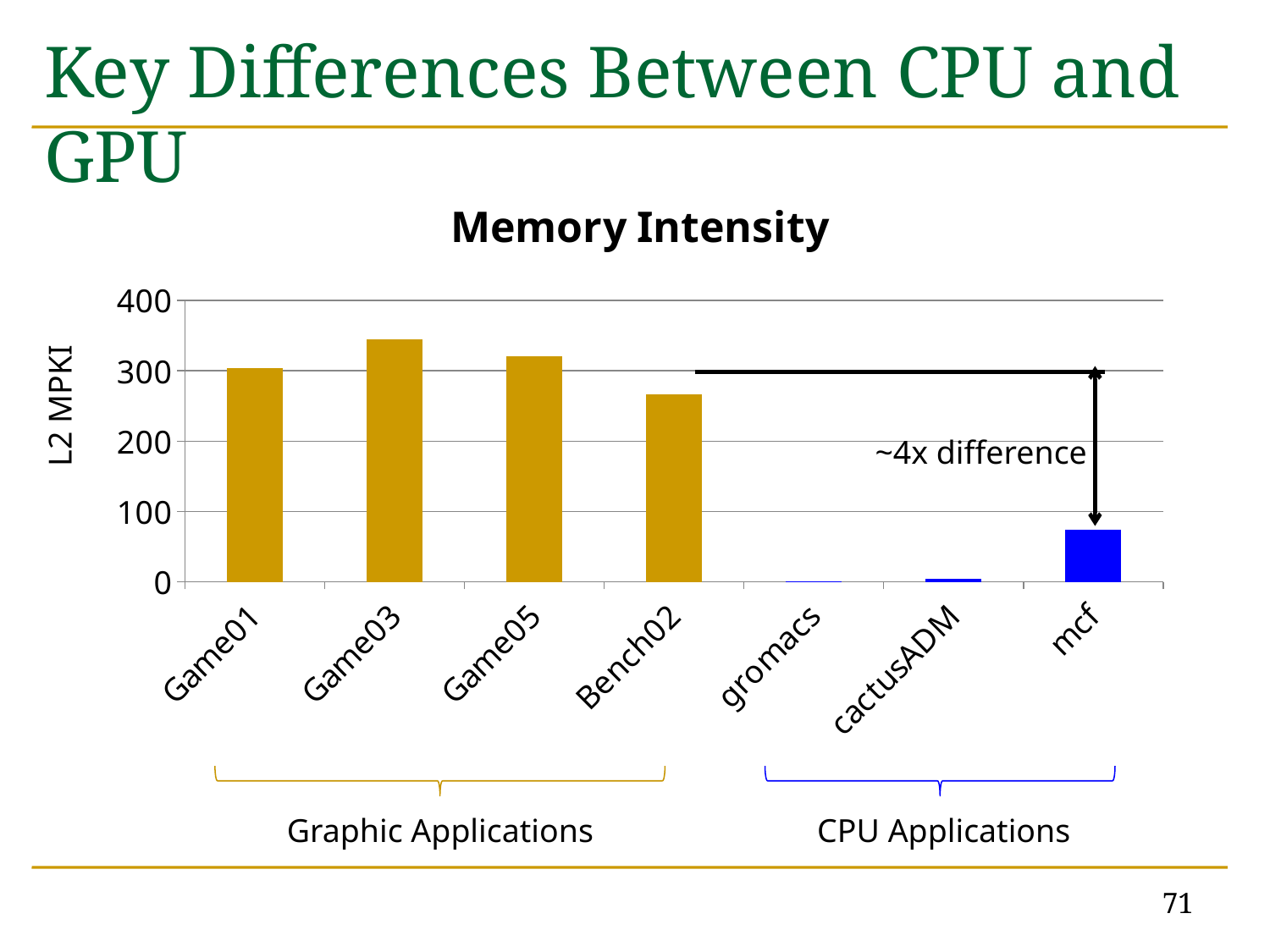
Is the value for Game03 greater or less than 300? greater Is the value for Bench02 greater or less than 300? less Which has a larger L2 MPKI, mcf or cactusADM? mcf Among the Graphic Applications (Game01, Game03, Game05, Bench02), which has the lowest L2 MPKI? Bench02 Which category has the highest L2 MPKI in the Memory Intensity chart? Game03 What kind of chart is shown on the slide? bar chart Which has a larger L2 MPKI, Game03 or Bench02? Game03 Is the value for mcf greater or less than 100? less How many categories are plotted on the x axis of the Memory Intensity chart? 7 What is the label of the y axis in the Memory Intensity chart? L2 MPKI